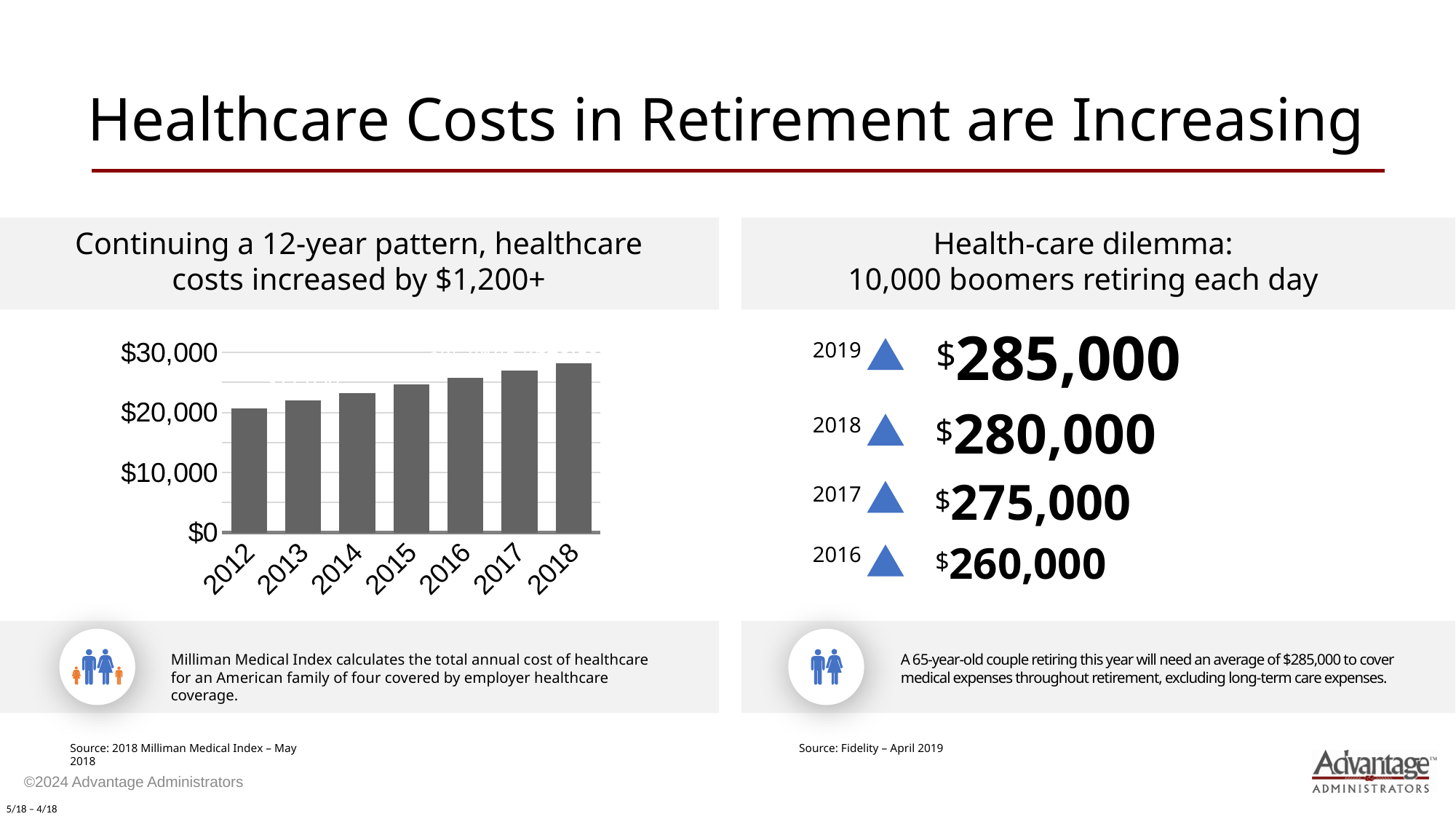
Is the value for 2018 in the bar chart greater or less than $30,000? less Is the value for 2015 in the bar chart greater or less than $20,000? greater In the bar chart, which is larger, the value for 2014 or the value for 2017? 2017 Which year has the tallest bar in the bar chart? 2018 How many years are shown on the x axis of the bar chart? 7 What is the first year shown on the x axis of the bar chart? 2012 In the bar chart, is the bar for 2018 taller or shorter than the bar for 2012? taller What kind of chart is shown on the left side of the slide? bar chart Do the bars in the bar chart rise or fall from 2012 to 2018? rise Which year has the shortest bar in the bar chart? 2012 Is the value for 2018 in the bar chart greater or less than $20,000? greater What is the highest tick label on the y axis of the bar chart? $30,000